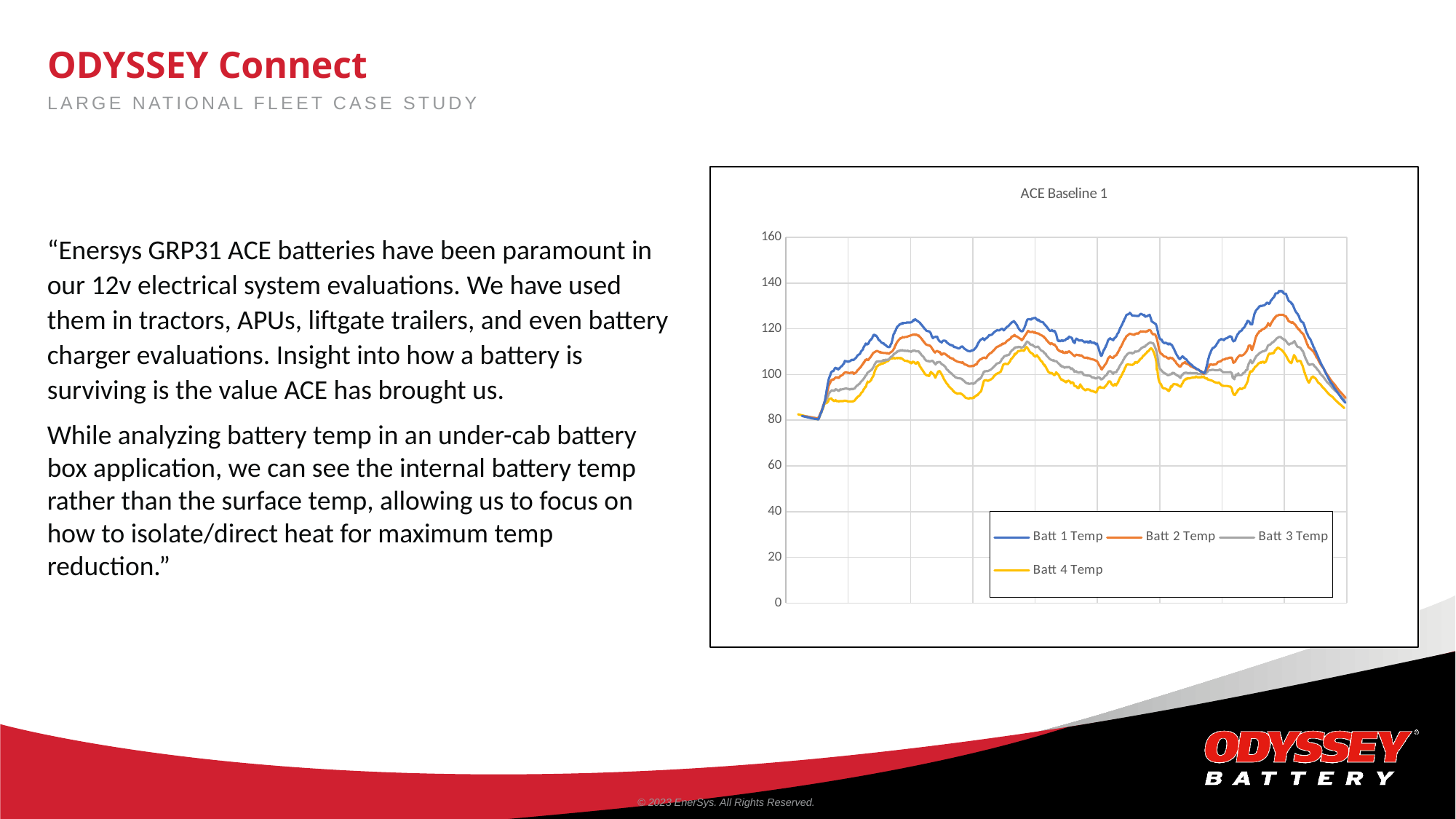
How many series does the chart legend list? 4 Which series stays lowest across the chart? Batt 4 Temp Which series is shown in yellow in the chart legend? Batt 4 Temp Do the series values rise or fall at the far right end of the chart? fall Is the highest value reached by Batt 4 Temp greater or less than 120? less Which series stays highest across the chart? Batt 1 Temp Is the value at which all four series start on the left greater or less than 100? less At its highest peak, is Batt 1 Temp or Batt 4 Temp larger? Batt 1 Temp What kind of chart is shown on the slide? Line chart Is the highest value reached by Batt 1 Temp greater or less than 120? greater What is the title of the chart? ACE Baseline 1 What is the highest value shown on the vertical axis? 160